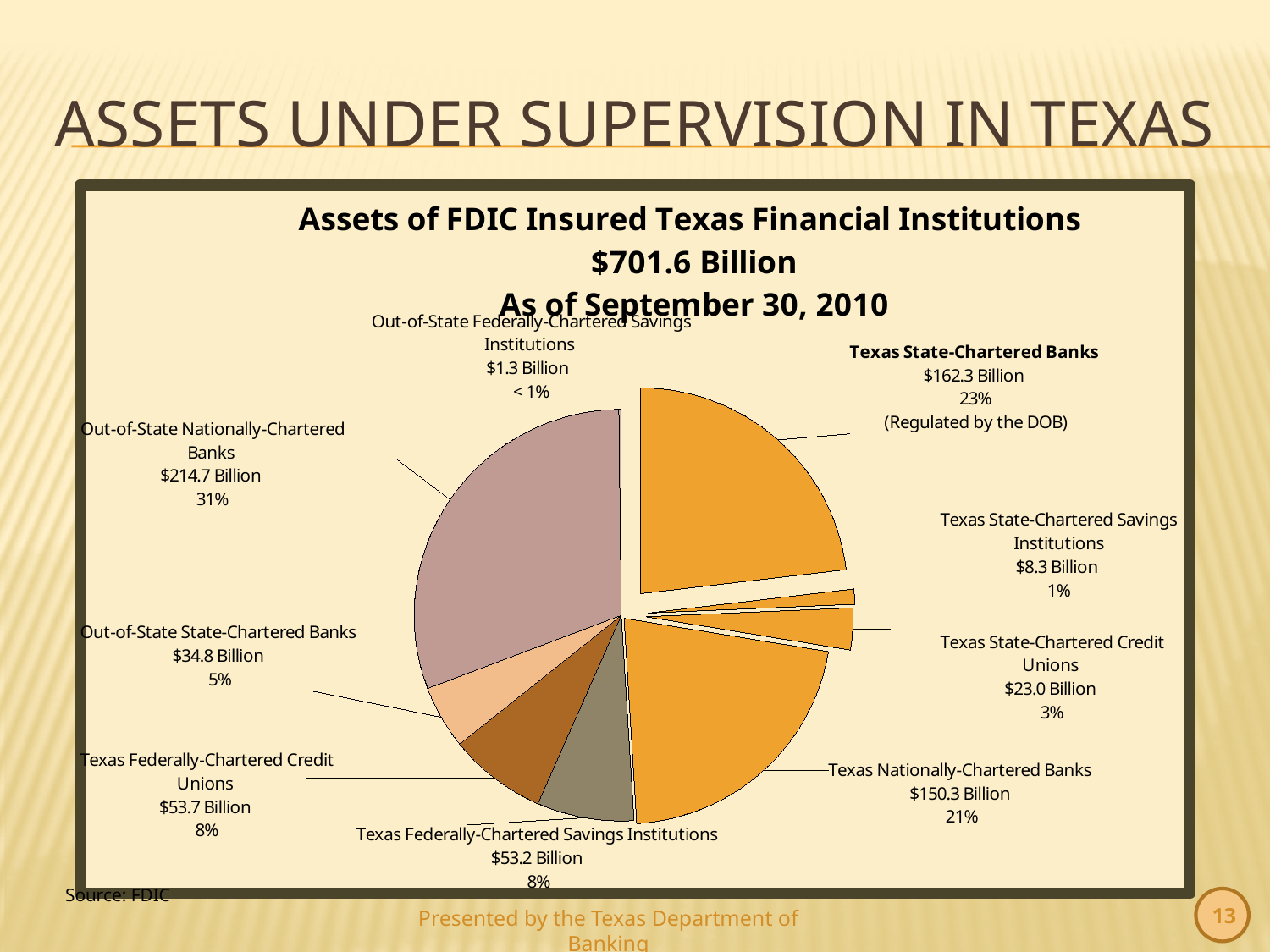
What is the asset value for Texas State-Chartered Banks? $162.3 Billion What is the total assets figure shown in the chart title? $701.6 Billion What is the asset value for Texas Nationally-Chartered Banks? $150.3 Billion How many slices does the pie chart have? 9 What share of the pie do Texas State-Chartered Credit Unions represent? 3% Which category has the smallest asset value? Out-of-State Federally-Chartered Savings Institutions What share of the pie do Out-of-State Nationally-Chartered Banks represent? 31% Which category has the largest asset value? Out-of-State Nationally-Chartered Banks What type of chart is shown on the slide? Pie chart As of what date are the assets reported in the chart? September 30, 2010 Which has more assets, Out-of-State State-Chartered Banks or Texas State-Chartered Credit Unions? Out-of-State State-Chartered Banks What is the difference in assets between Texas State-Chartered Banks and Texas Nationally-Chartered Banks? $12.0 Billion